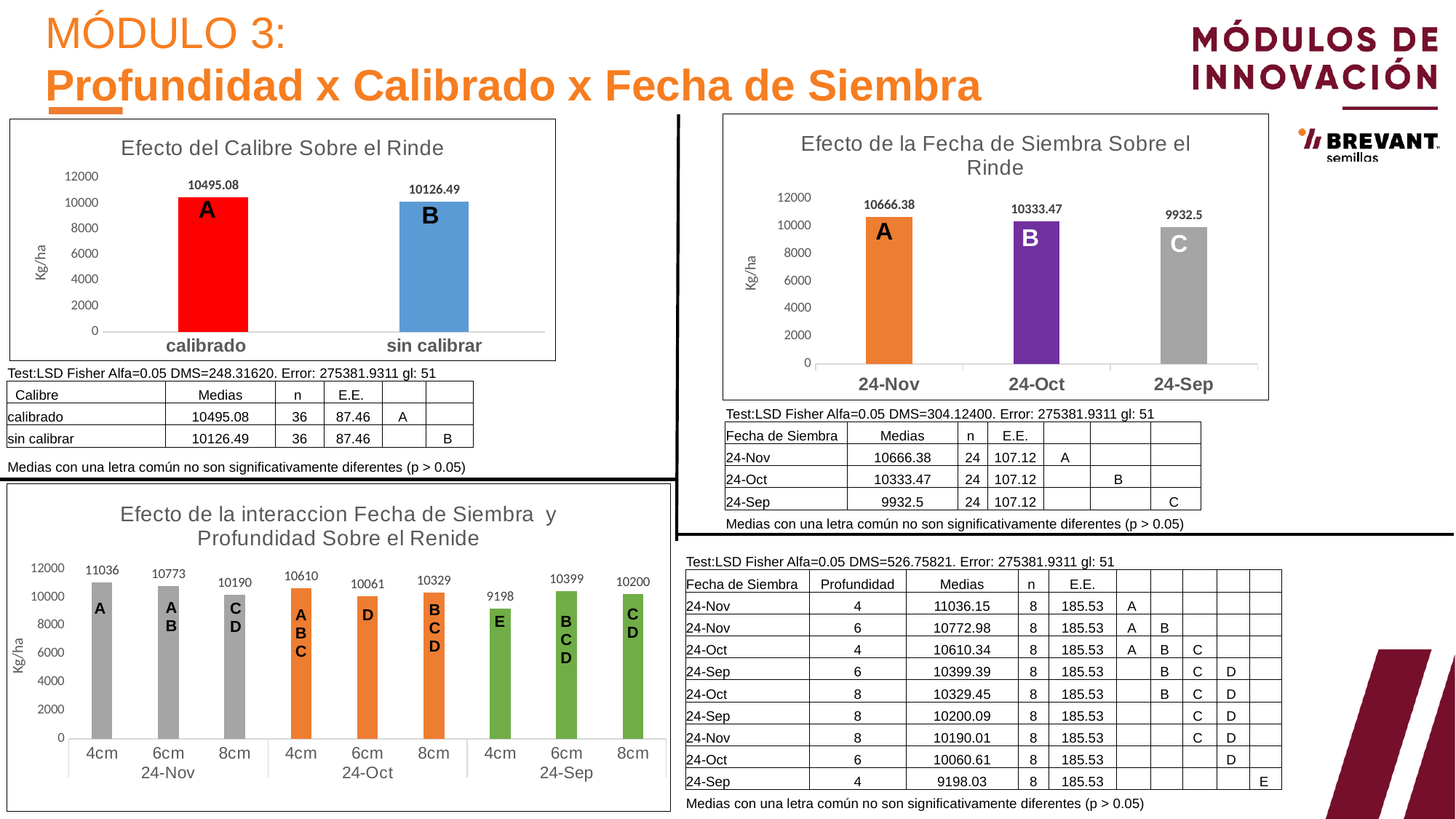
In the chart 'Efecto del Calibre Sobre el Rinde', what kind of chart is shown? bar chart In the chart 'Efecto de la Fecha de Siembra Sobre el Rinde', do the values rise or fall from left to right along the x axis? fall In the chart 'Efecto del Calibre Sobre el Rinde', what is the difference between 'calibrado' and 'sin calibrar'? 368.59 In the chart 'Efecto de la Fecha de Siembra Sobre el Rinde', which sowing date has the lowest value? 24-Sep In the chart 'Efecto del Calibre Sobre el Rinde', what is the value for 'calibrado'? 10495.08 In the chart 'Efecto de la Fecha de Siembra Sobre el Rinde', what is the value for '24-Oct'? 10333.47 In the chart 'Efecto de la interaccion Fecha de Siembra y Profundidad Sobre el Renide', how many bars are plotted? 9 In the chart 'Efecto de la interaccion Fecha de Siembra y Profundidad Sobre el Renide', which bar has the highest value? 4cm 24-Nov In the chart 'Efecto de la interaccion Fecha de Siembra y Profundidad Sobre el Renide', which is larger: 6cm at 24-Oct or 8cm at 24-Oct? 8cm at 24-Oct In the chart 'Efecto de la interaccion Fecha de Siembra y Profundidad Sobre el Renide', what is the difference between the highest bar (4cm 24-Nov) and the lowest bar (4cm 24-Sep)? 1838 In the chart 'Efecto de la Fecha de Siembra Sobre el Rinde', what is the difference between '24-Nov' and '24-Sep'? 733.88 In the chart 'Efecto de la interaccion Fecha de Siembra y Profundidad Sobre el Renide', what is the value for 6cm at 24-Sep? 10399